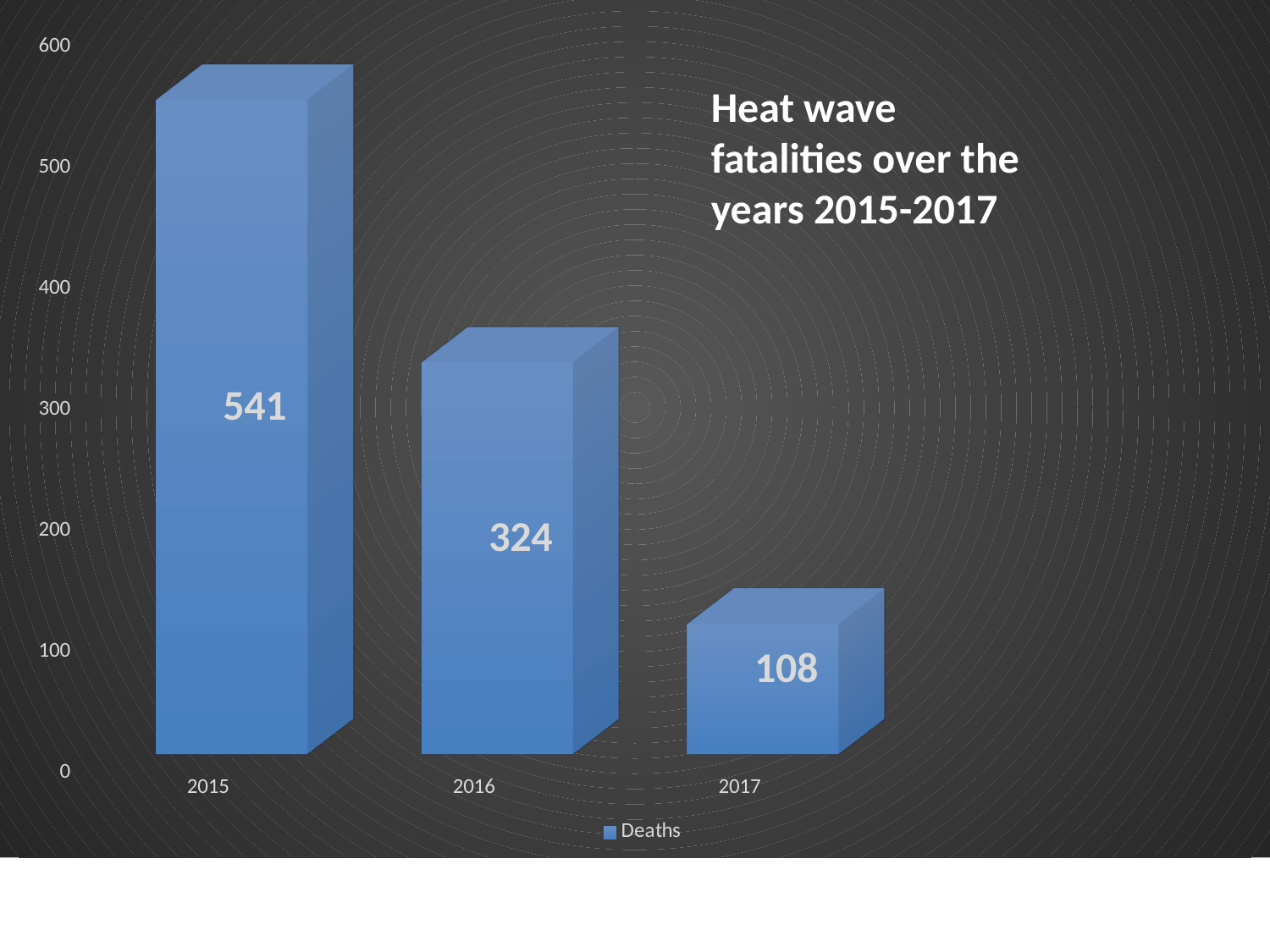
Which year had more deaths, 2016 or 2017? 2016 What kind of chart is shown on the slide? Bar chart What is the difference in deaths between 2016 and 2017? 216 How many years are shown on the x axis? 3 Which year has the highest number of deaths? 2015 What is the value for 2016? 324 Do the values rise or fall from 2015 to 2017? Fall Is the value for 2015 greater or less than 500? greater Which year has the lowest number of deaths? 2017 What is the difference in deaths between 2015 and 2016? 217 How many heat wave deaths were recorded in 2015? 541 How many deaths does the chart show for 2017? 108